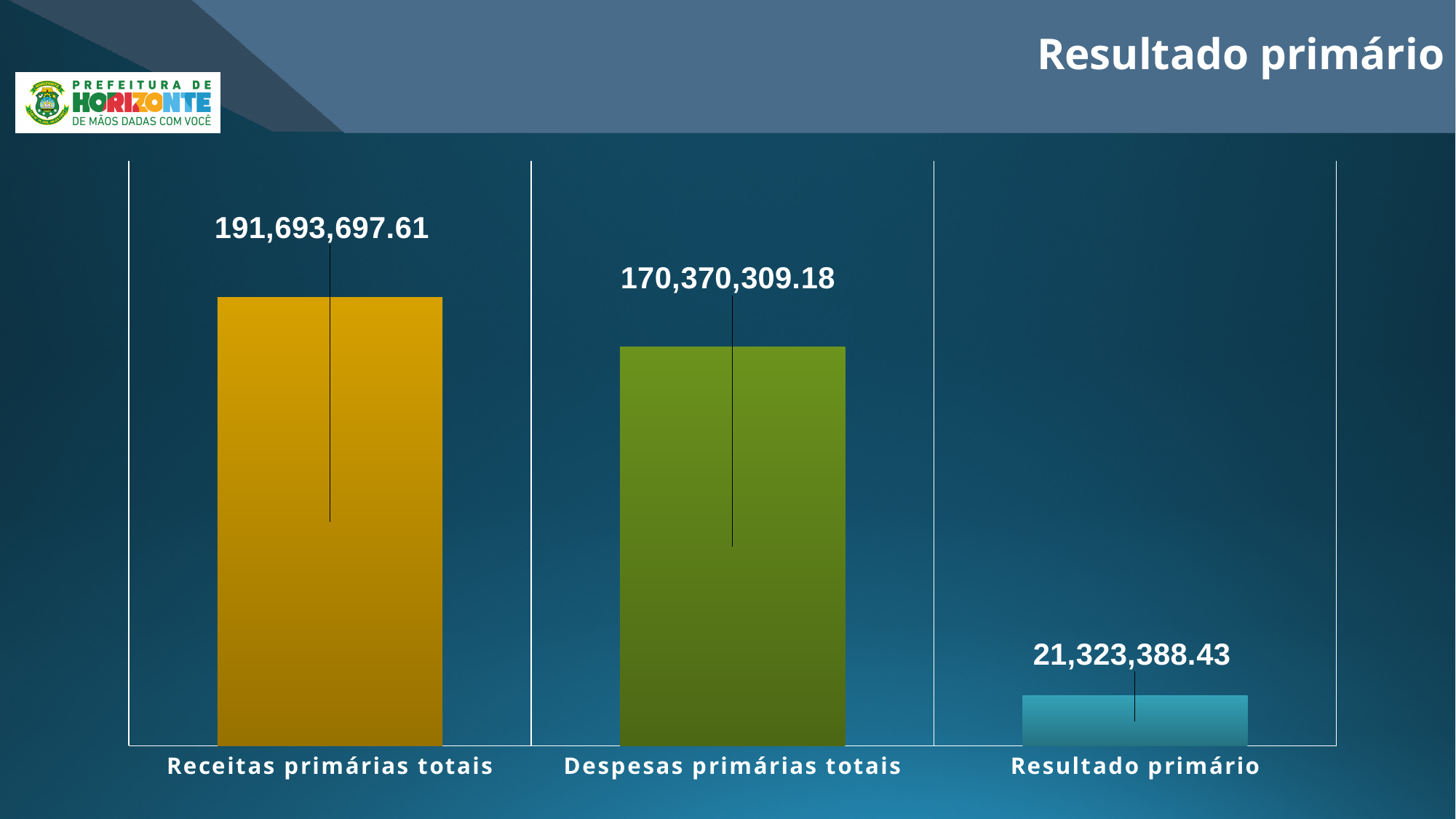
How many categories are shown in the chart? 3 What is the difference between Despesas primárias totais and Resultado primário? 149,046,920.75 What is the difference between Receitas primárias totais and Despesas primárias totais? 21,323,388.43 What is the value shown for Receitas primárias totais? 191,693,697.61 Which category has the lowest value? Resultado primário What is the title of the slide? Resultado primário What kind of chart is shown on the slide? Bar chart What is the value shown for Despesas primárias totais? 170,370,309.18 What is the value shown for Resultado primário? 21,323,388.43 Which category has the highest value? Receitas primárias totais Do the values rise or fall from left to right across the categories? Fall Which is larger, Receitas primárias totais or Despesas primárias totais? Receitas primárias totais